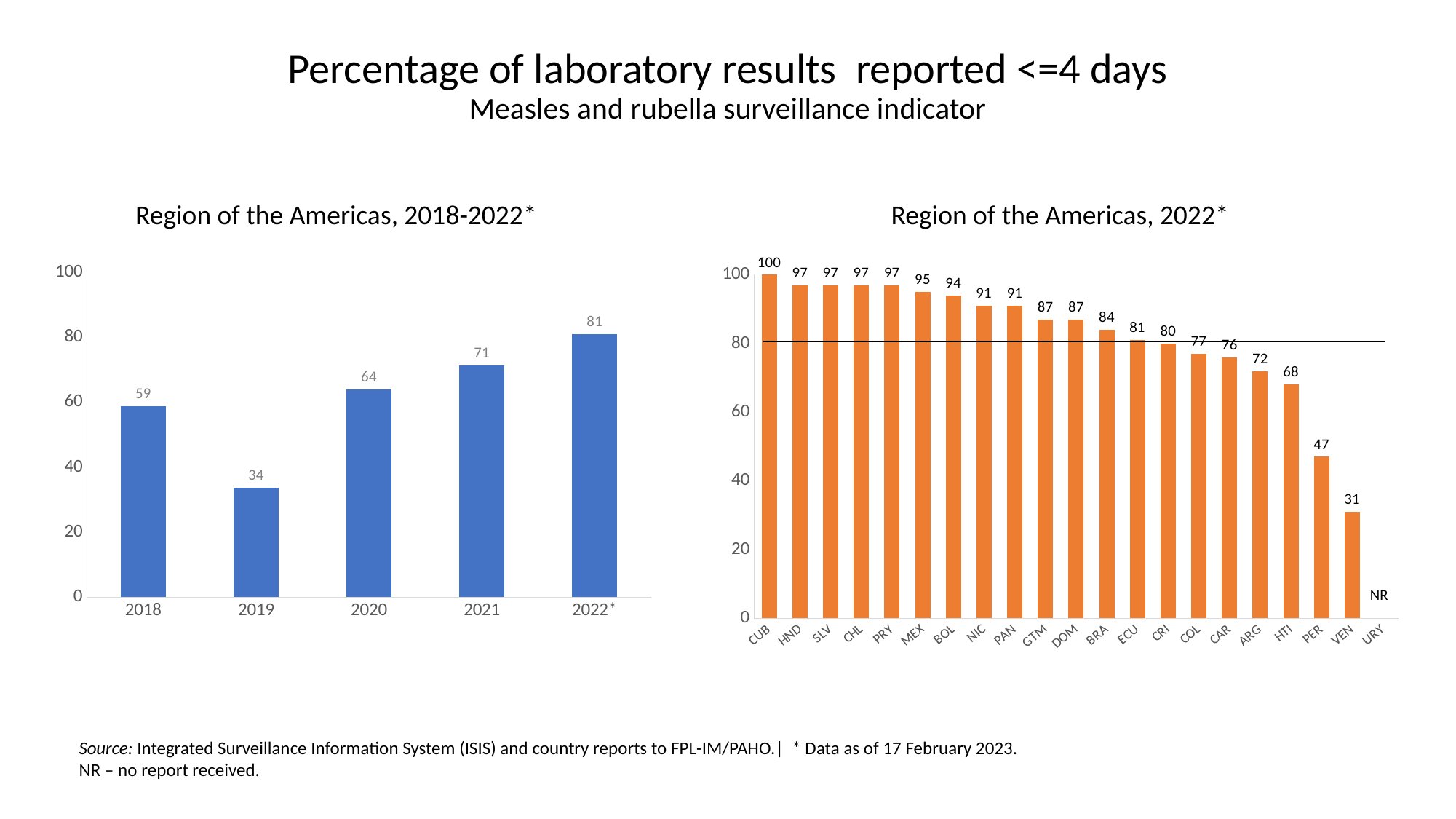
In the 'Region of the Americas, 2022*' chart, what is the value for MEX? 95 In the 'Region of the Americas, 2018-2022*' chart, which year has the lowest value? 2019 In the 'Region of the Americas, 2018-2022*' chart, what is the difference between the values for 2022* and 2018? 22 In the 'Region of the Americas, 2018-2022*' chart, which year has the highest value? 2022* In the 'Region of the Americas, 2018-2022*' chart, what is the value for 2019? 34 What kind of chart is the 'Region of the Americas, 2022*' chart? bar chart In the 'Region of the Americas, 2022*' chart, what is the difference between the values for BRA and VEN? 53 In the 'Region of the Americas, 2022*' chart, which of HTI or ARG has the larger value? ARG In the 'Region of the Americas, 2022*' chart, which country has the highest value? CUB In the 'Region of the Americas, 2018-2022*' chart, how many years are plotted? 5 In the 'Region of the Americas, 2018-2022*' chart, do the values rise or fall from 2019 to 2022*? rise In the 'Region of the Americas, 2022*' chart, what is the value for PER? 47